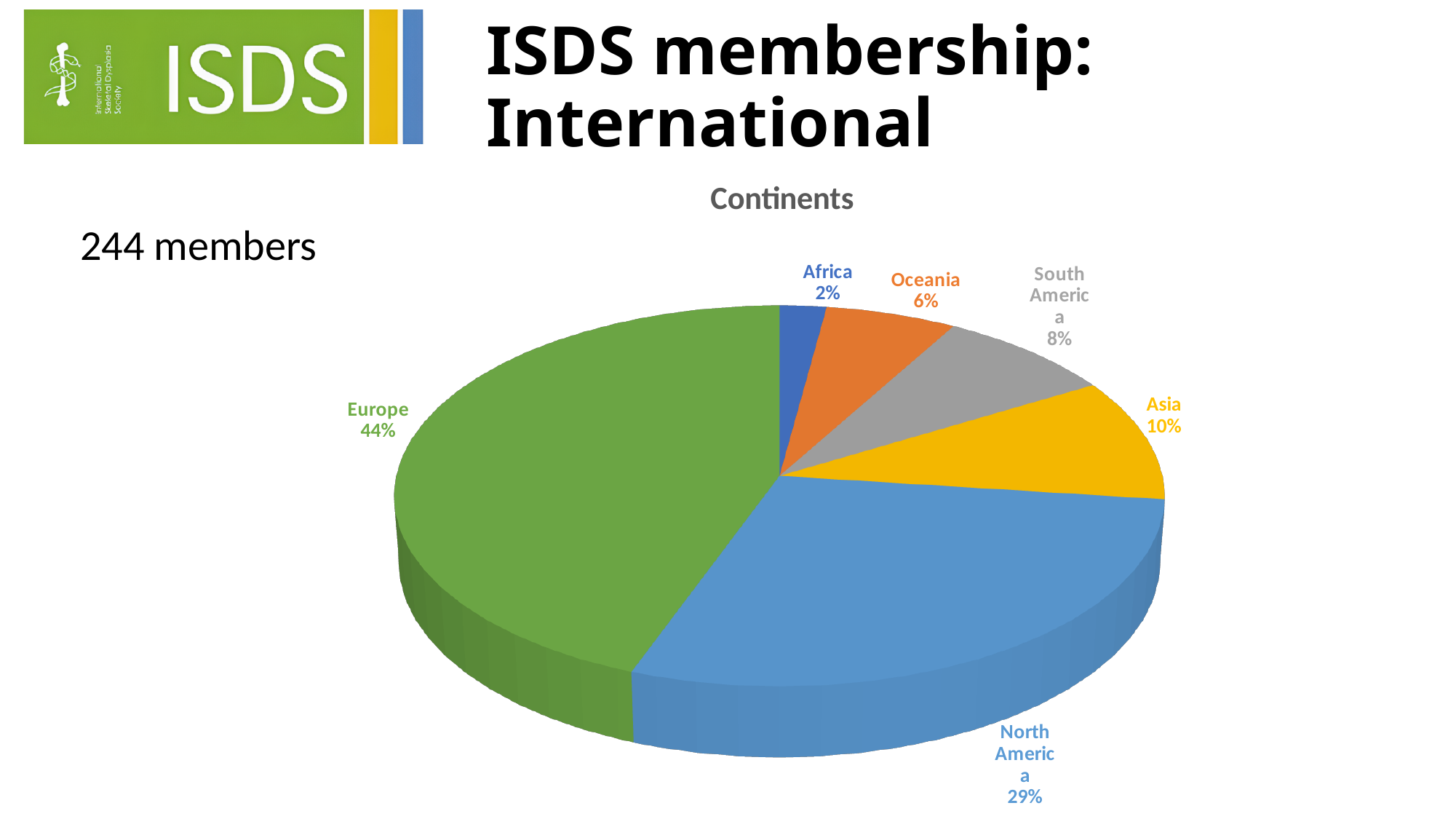
Which continent has the largest share of the pie? Europe Which continent has the smallest share of the pie? Africa How many continents are shown in the pie chart? 6 What is the difference in percentage points between Europe and North America? 15 What percentage is shown for Asia? 10% What share of the pie does Europe account for? 44% Which has a larger share, Asia or South America? Asia What percentage is shown for South America? 8% What kind of chart is shown on the slide? Pie chart What is the title of the chart? Continents What is the value shown for North America? 29% What percentage is shown for Oceania? 6%